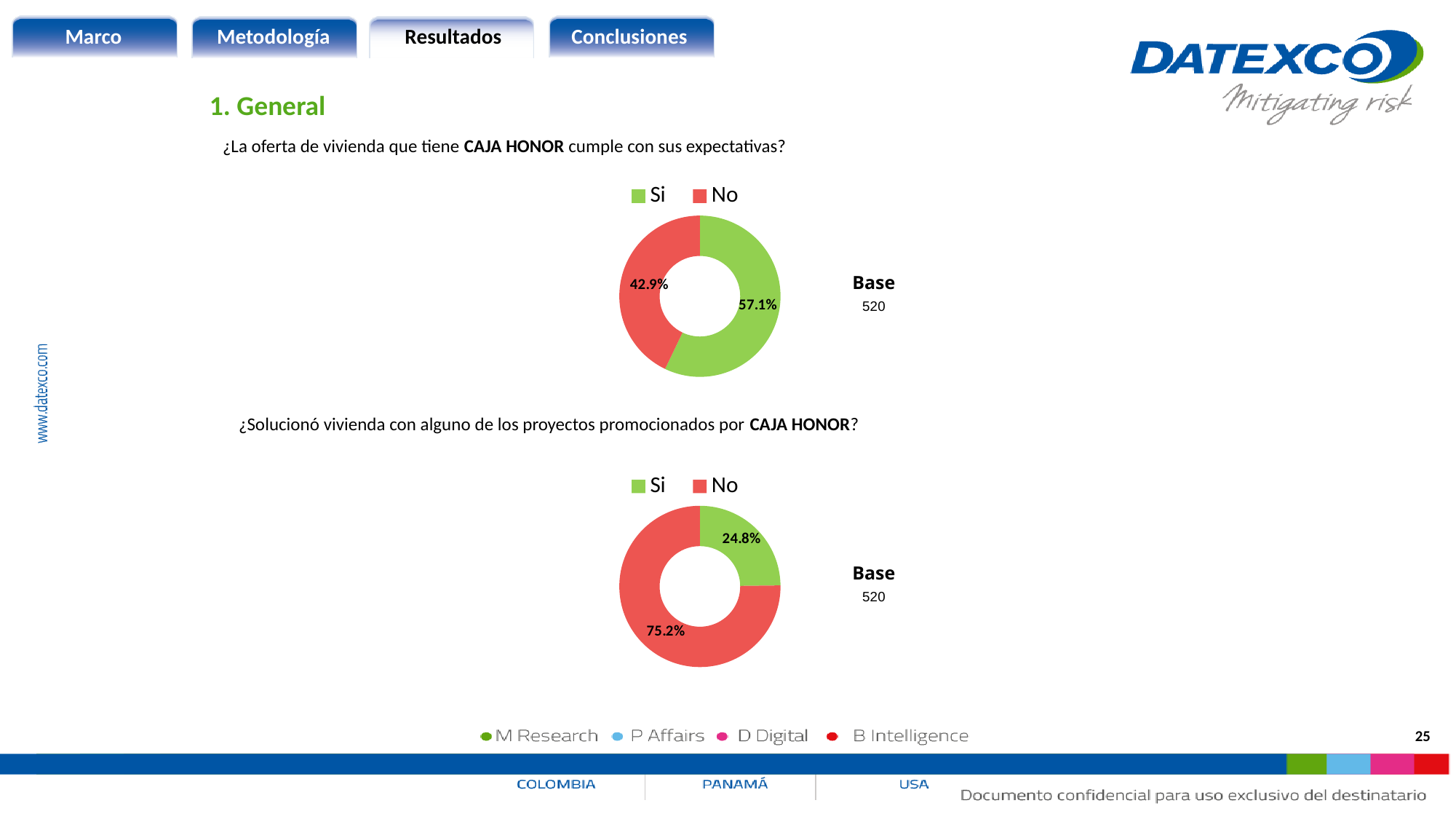
In the top chart (¿La oferta de vivienda que tiene CAJA HONOR cumple con sus expectativas?), what percentage answered No? 42.9% How many categories does the legend of the bottom chart list? 2 In the bottom chart, which response has the largest share? No In the top chart (¿La oferta de vivienda que tiene CAJA HONOR cumple con sus expectativas?), what percentage answered Si? 57.1% In the top chart, which response has the larger share, Si or No? Si In the top chart, what is the difference in percentage points between Si and No? 14.2 What type of chart is used for the top question about CAJA HONOR's housing offer? Doughnut (pie) chart In the bottom chart, which response has the smallest share? Si In the bottom chart (¿Solucionó vivienda con alguno de los proyectos promocionados por CAJA HONOR?), what percentage answered No? 75.2% In the bottom chart, what is the difference in percentage points between No and Si? 50.4 What is the Base shown next to the top chart? 520 In the bottom chart (¿Solucionó vivienda con alguno de los proyectos promocionados por CAJA HONOR?), what percentage answered Si? 24.8%